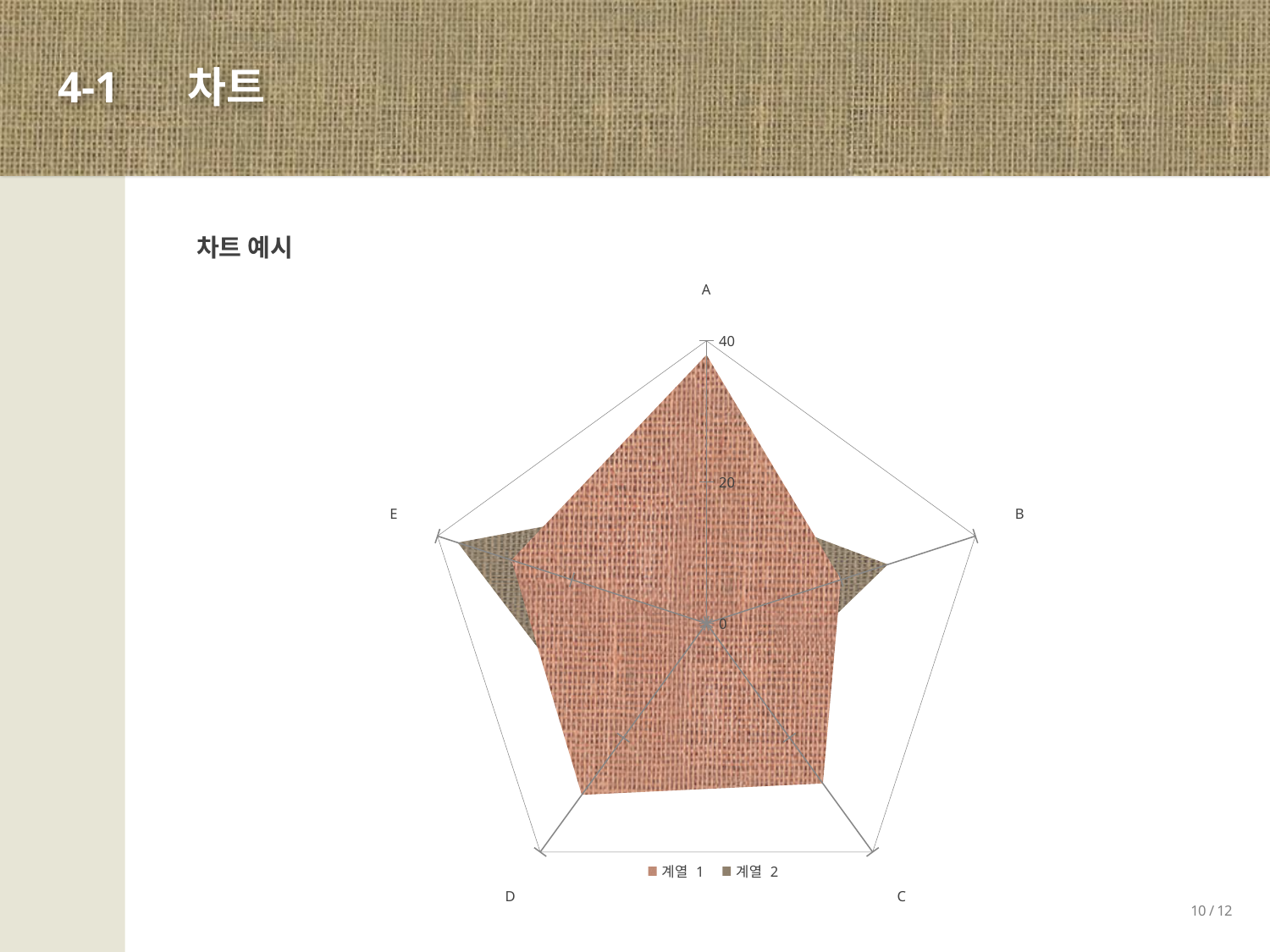
How many categories are plotted on the radar chart? 5 For category E, which series has the larger value, 계열 1 or 계열 2? 계열 2 What kind of chart is shown on the slide? radar chart For 계열 1, which category has the larger value, A or B? A For which category does 계열 1 reach its highest value? A Is the value of 계열 2 for category E greater or less than 20? greater How many series does the legend list? 2 What are the names of the two series in the legend? 계열 1, 계열 2 Is the value of 계열 1 for category A greater or less than 20? greater What is the highest value shown on the radar chart's axis? 40 Is the value of 계열 1 for category D greater or less than 20? greater